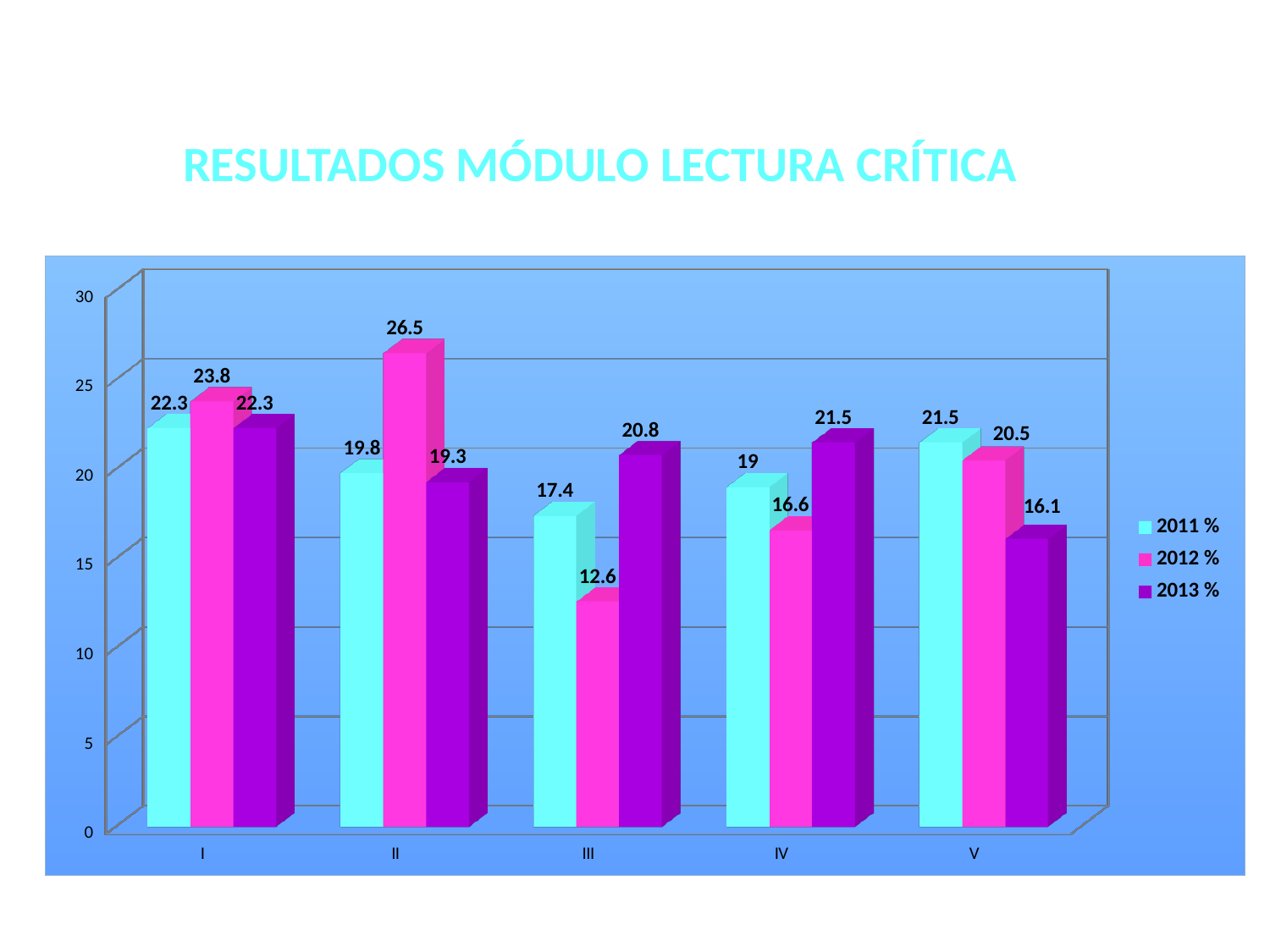
What is the difference between the 2012 % and 2013 % values for category II? 7.2 What is the title of the chart? RESULTADOS MÓDULO LECTURA CRÍTICA What is the 2012 % value for category III? 12.6 How many series does the legend list? 3 Which category has the highest 2012 % value? II What is the difference between the 2011 % values for category I and category III? 4.9 What is the 2011 % value for category II? 19.8 How many categories are shown on the x axis? 5 Which is larger for category IV: the 2011 % value or the 2013 % value? 2013 % What is the 2013 % value for category V? 16.1 Which category has the lowest 2013 % value? V What kind of chart is shown on the slide? bar chart